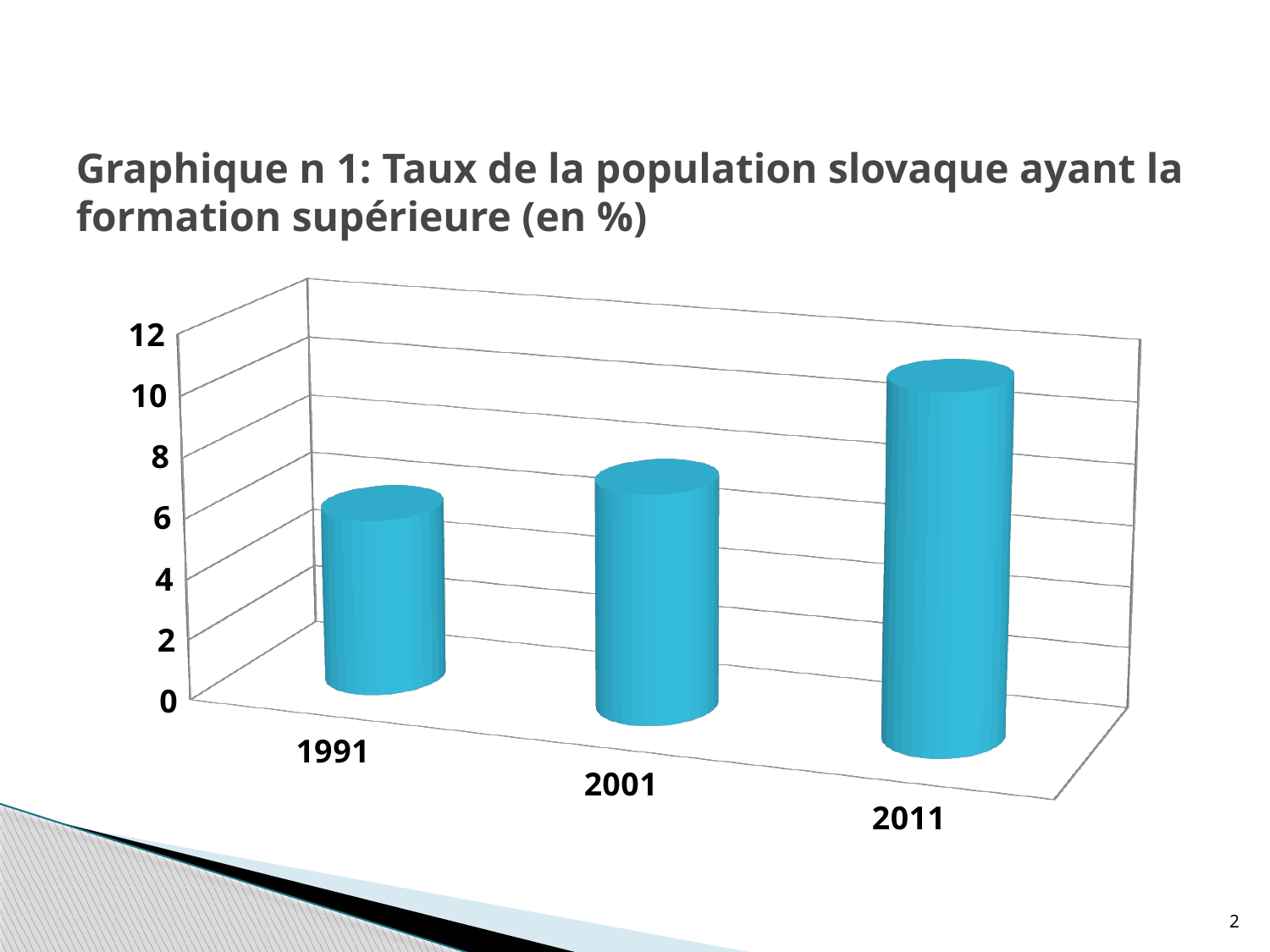
Which is larger, the value for 2001 or the value for 2011? 2011 Which year has the highest value on the chart? 2011 Is the value for 1991 greater or less than 8? less Which year has the lowest value on the chart? 1991 Which is larger, the value for 1991 or the value for 2001? 2001 How many years (categories) are plotted on the chart? 3 Is the value for 2011 greater or less than 8? greater Do the values rise or fall from 1991 to 2011? rise What kind of chart is shown on the slide? bar chart Is the value for 2001 greater or less than 6? greater What is the title of the chart on the slide? Graphique n 1: Taux de la population slovaque ayant la formation supérieure (en %)